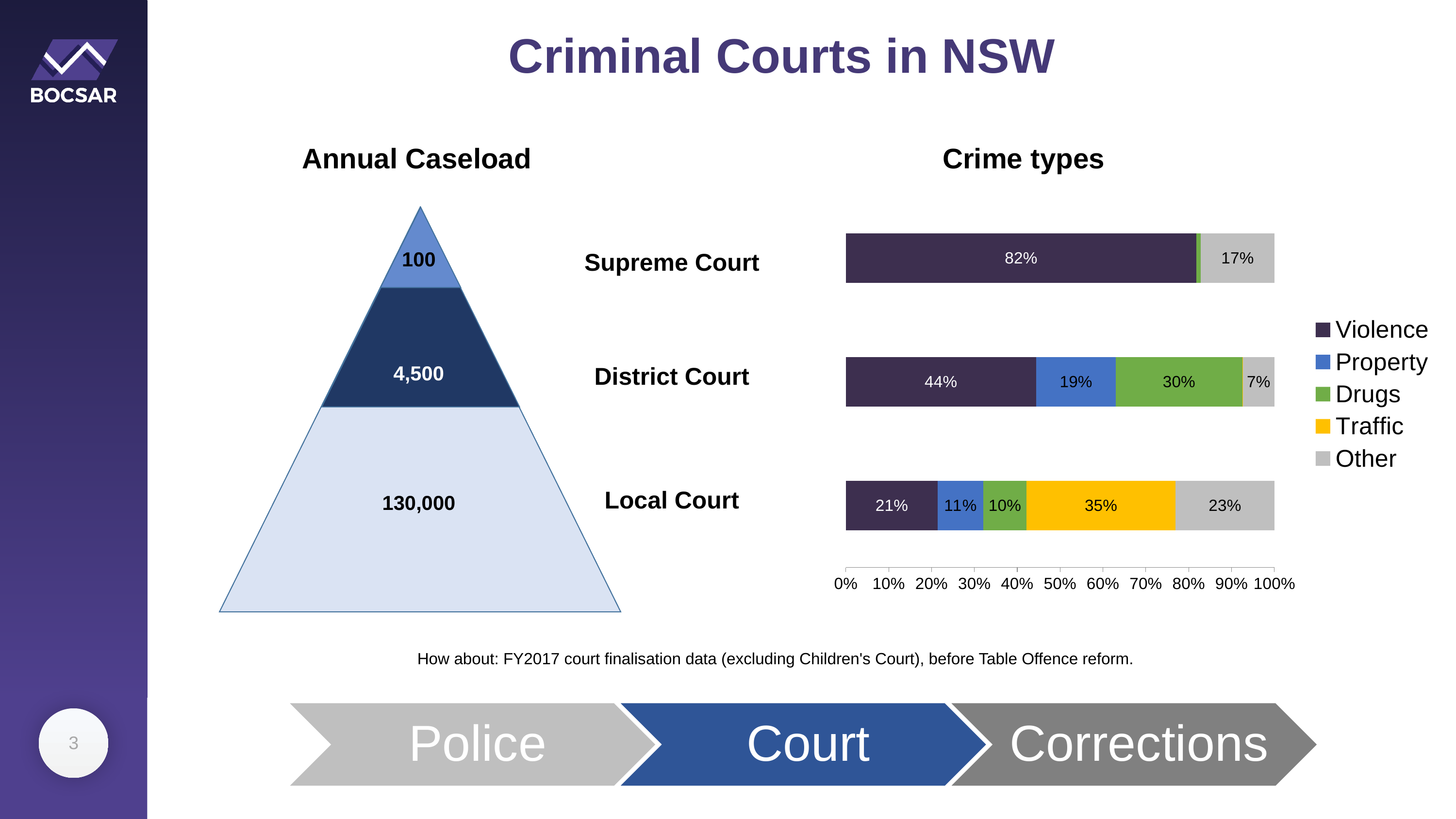
In the Crime types chart, what share of Local Court cases are Traffic offences? 35% In the Crime types chart, how many percentage points higher is the Drugs share for the District Court than for the Local Court? 20 percentage points In the Crime types chart, which court has the highest share of Violence offences? Supreme Court In the Annual Caseload pyramid, what is the annual caseload of the District Court? 4,500 In the Crime types chart, what percentage of Supreme Court cases fall under Other? 17% What kind of chart is the Crime types chart? Stacked bar chart In the Crime types chart, is the Property share or the Drugs share larger for the Local Court? Property In the Crime types chart, which court has the lowest share of Violence offences? Local Court How many courts are shown in the Crime types chart? 3 In the Crime types chart, what percentage of District Court cases are Violence offences? 44% How many crime types does the legend of the Crime types chart list? 5 In the Crime types chart, what is the total of the Local Court bar's labelled segments? 100%